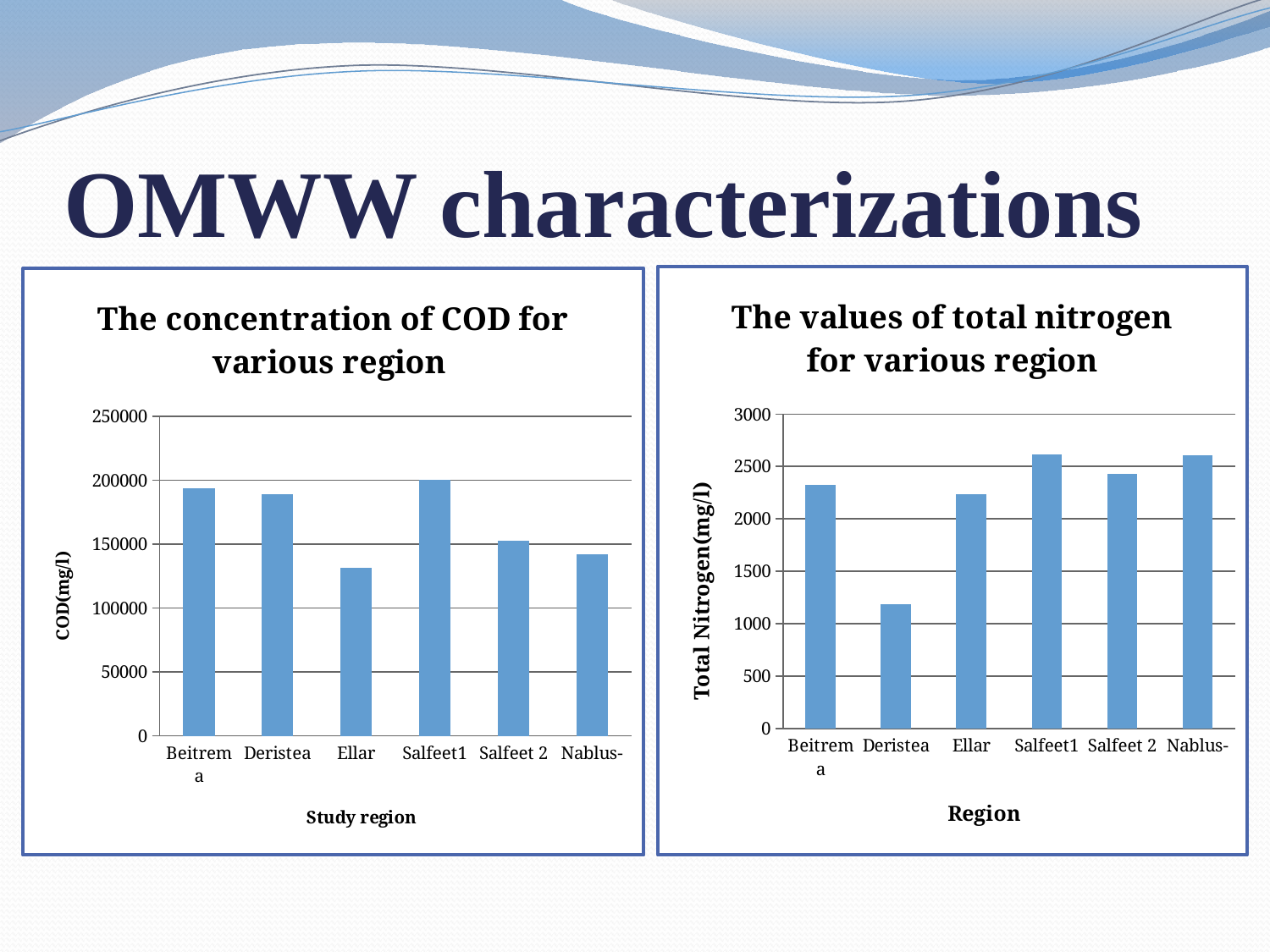
In the chart titled 'The values of total nitrogen for various region', is the value for Salfeet1 greater or less than 2500? greater In the chart titled 'The values of total nitrogen for various region', what is the y-axis title? Total Nitrogen(mg/l) What kind of chart is the chart titled 'The values of total nitrogen for various region'? bar chart In the chart titled 'The values of total nitrogen for various region', is the value for Deristea greater or less than 1500? less In the chart titled 'The concentration of COD for various region', how many regions are shown on the x axis? 6 In the chart titled 'The concentration of COD for various region', which region has the lowest COD value? Ellar In the chart titled 'The concentration of COD for various region', is the value for Salfeet1 greater or less than 150000? greater In the chart titled 'The values of total nitrogen for various region', which is larger, the value for Beitrema or the value for Deristea? Beitrema In the chart titled 'The values of total nitrogen for various region', which region has the lowest total nitrogen value? Deristea In the chart titled 'The concentration of COD for various region', what is the x-axis title? Study region In the chart titled 'The concentration of COD for various region', which is larger, the value for Ellar or the value for Salfeet 2? Salfeet 2